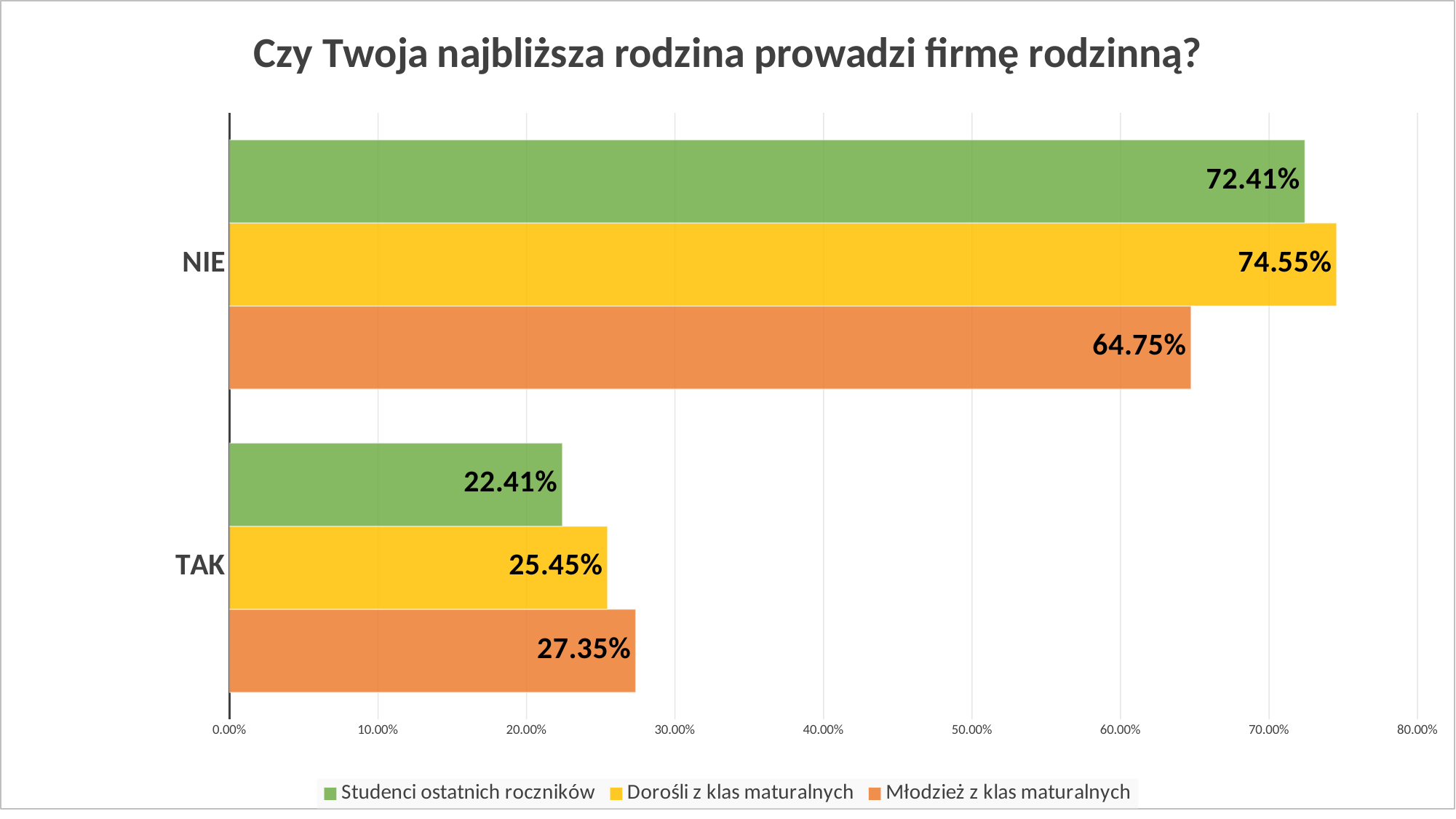
Which series has the highest value in the NIE category? Dorośli z klas maturalnych What kind of chart is shown on the slide? bar chart How many categories are shown on the vertical axis? 2 Which series has the lowest value in the TAK category? Studenci ostatnich roczników What is the difference between the NIE and TAK values for 'Młodzież z klas maturalnych'? 37.40% What is the value for 'Młodzież z klas maturalnych' in the TAK category? 27.35% How many series does the legend list? 3 Is the value for 'Młodzież z klas maturalnych' in the NIE category greater or less than 70.00%? less What is the title of the chart? Czy Twoja najbliższa rodzina prowadzi firmę rodzinną? Which is larger in the TAK category: 'Dorośli z klas maturalnych' or 'Studenci ostatnich roczników'? Dorośli z klas maturalnych What is the value for 'Studenci ostatnich roczników' in the NIE category? 72.41% What is the value for 'Dorośli z klas maturalnych' in the NIE category? 74.55%